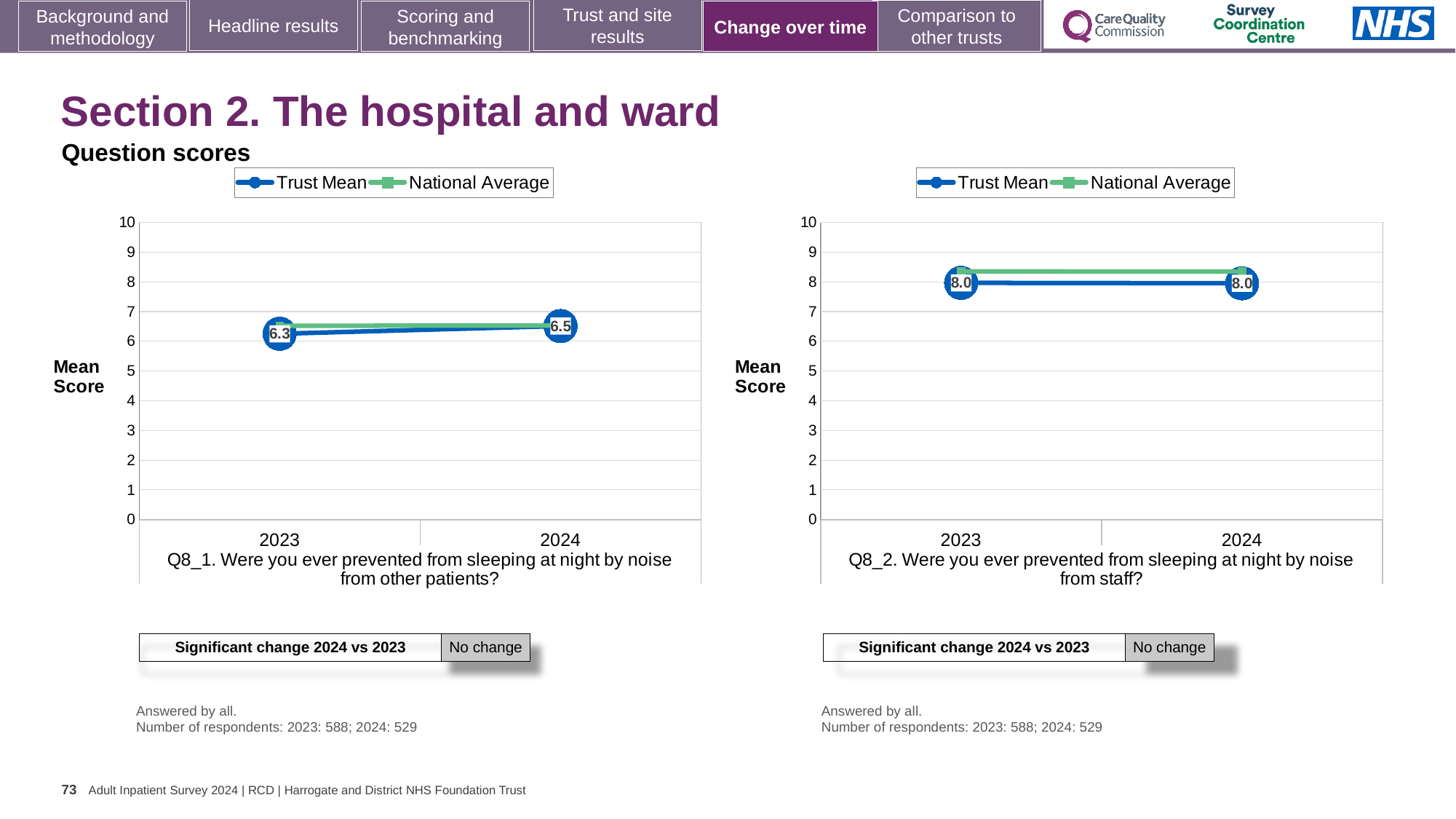
In the Q8_1 chart (left), does the Trust Mean rise or fall from 2023 to 2024? rise In the Q8_1 chart (left), by how much did the Trust Mean change from 2023 to 2024? 0.2 In the Q8_1 chart (left), which year has the higher Trust Mean, 2023 or 2024? 2024 In the Q8_2 chart (right), is the National Average for 2023 greater or less than 8? greater In the Q8_1 chart (left), what is the Trust Mean score for 2023? 6.3 How many years are plotted on the x axis of the Q8_1 chart (left)? 2 In the Q8_1 chart (left), is the National Average for 2024 greater or less than 6? greater In the Q8_2 chart (right), what is the Trust Mean score for 2024? 8.0 In the Q8_1 chart (left), what is the Trust Mean score for 2024? 6.5 In the Q8_2 chart (right), what is the Trust Mean score for 2023? 8.0 What type of chart is the Q8_2 chart (right)? line chart How many series does the legend of the Q8_2 chart (right) list? 2